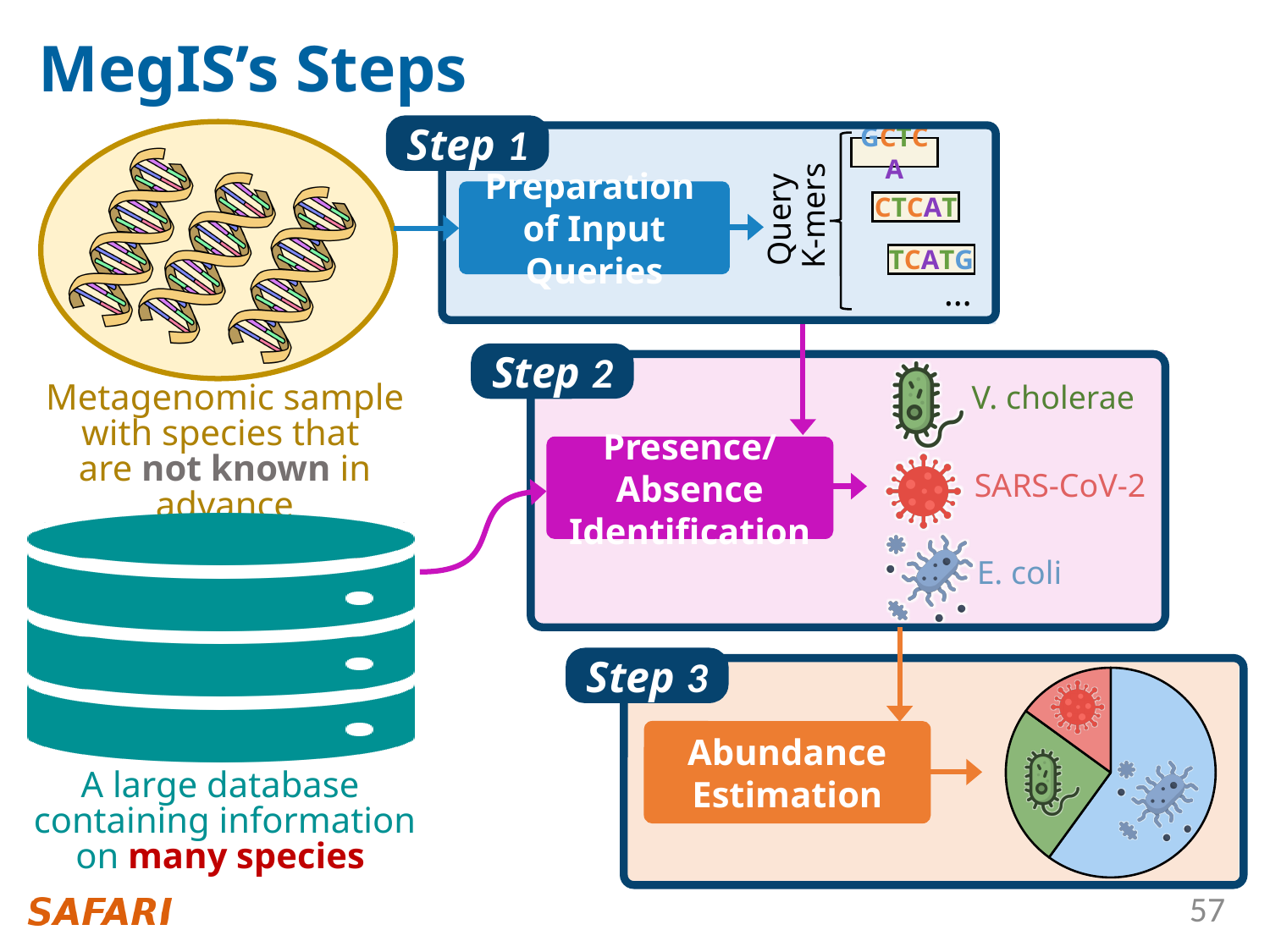
In the Step 3 pie chart, which is larger, the blue slice or the red slice? blue How many slices does the pie chart in Step 3 have? 3 Which process box points to the pie chart in Step 3? Abundance Estimation Which step of MegIS contains the pie chart? Step 3 In the Step 3 pie chart, is the blue slice larger or smaller than the red and green slices combined? larger In the Step 3 pie chart, which is larger, the blue slice or the green slice? blue What kind of chart is shown in the Step 3 box? pie chart Which colour slice is the largest in the Step 3 pie chart? blue